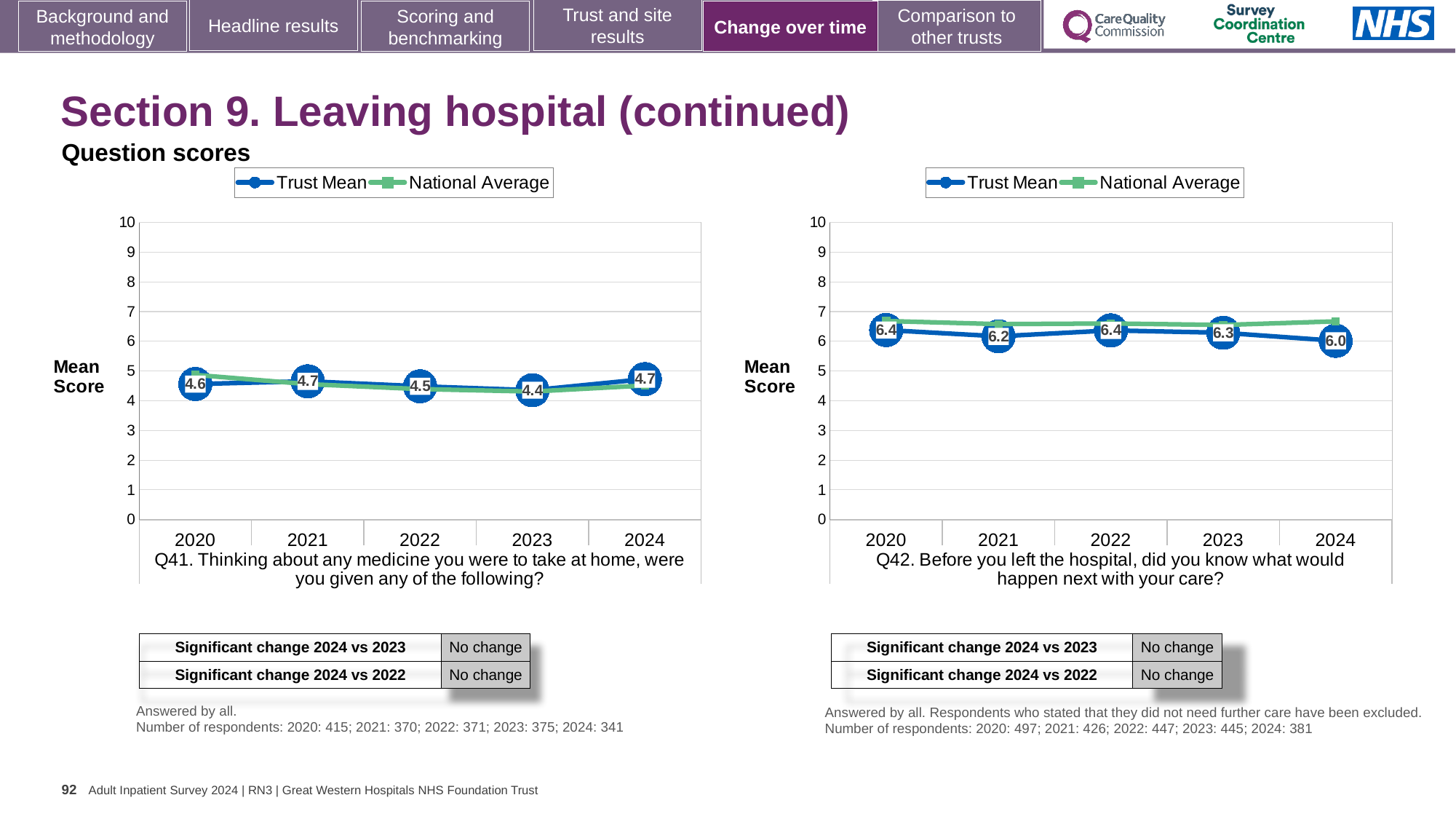
In the Q42 chart, which year has the lowest Trust Mean score? 2024 In the Q41 chart, is the National Average value for 2024 greater or less than 4? greater In the Q41 chart, what is the Trust Mean score for 2024? 4.7 What type of chart is used for Q42? Line chart In the Q42 chart, is the National Average value for 2024 greater or less than 7? less In the Q41 chart, what is the difference between the Trust Mean scores for 2024 and 2023? 0.3 In the Q42 chart, what is the difference between the Trust Mean scores for 2020 and 2024? 0.4 In the Q42 chart, what is the Trust Mean score for 2021? 6.2 How many years are shown on the x axis of the Q41 chart? 5 How many series does the legend of the Q42 chart list? 2 In the Q42 chart, is the Trust Mean score higher in 2022 or in 2024? 2022 In the Q41 chart, which year has the lowest Trust Mean score? 2023